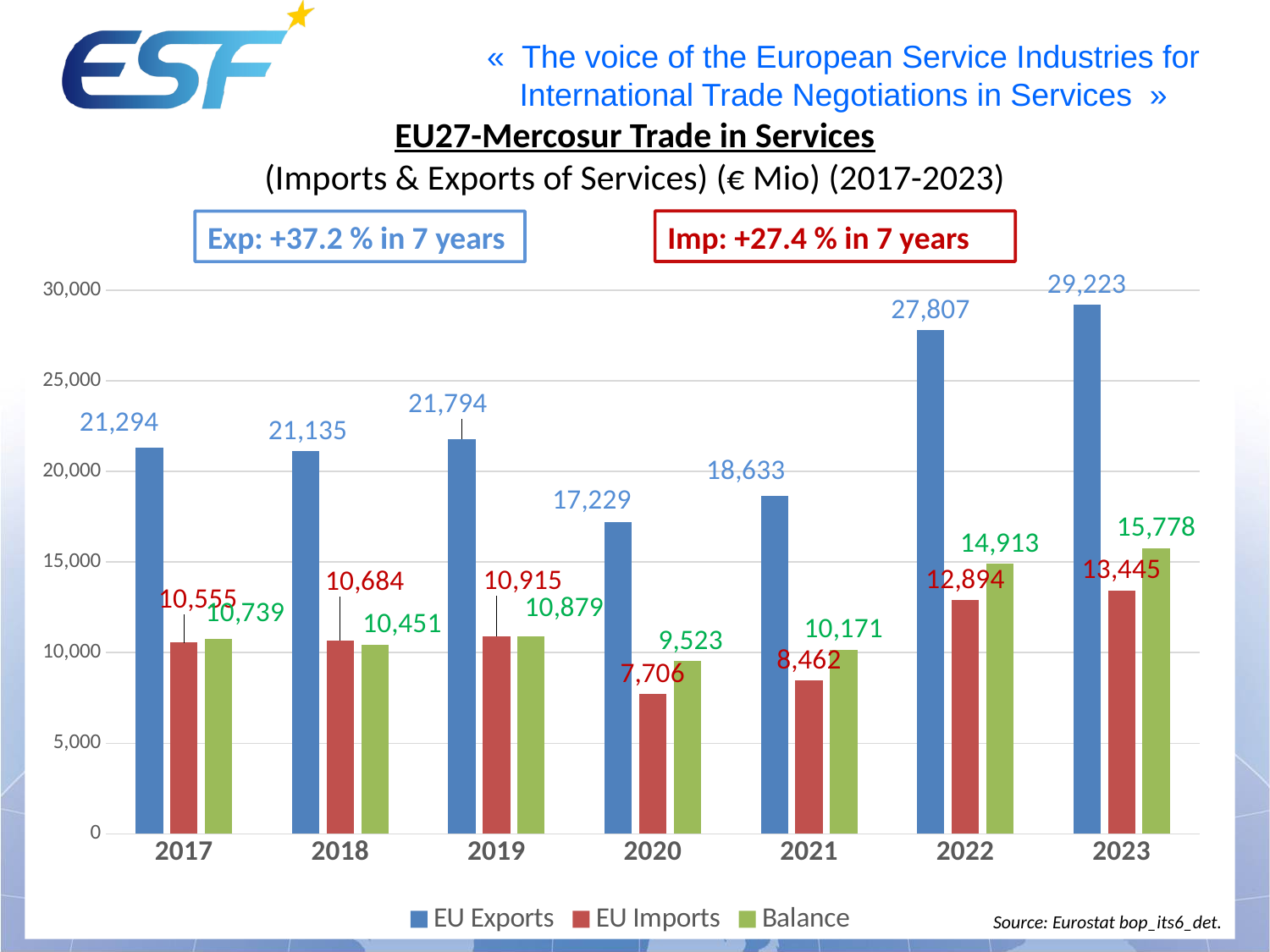
What is the difference between EU Imports in 2021 and EU Imports in 2020? 756 How many years are shown on the x axis? 7 How many series does the legend list? 3 In which year are EU Imports lowest? 2020 What is the value of EU Imports in 2020? 7,706 Is the value for EU Exports in 2021 greater or less than 20,000? less What is the value of EU Exports in 2023? 29,223 What kind of chart is shown on the slide? bar chart What is the Balance value for 2022? 14,913 Which is larger in 2019: EU Imports or Balance? EU Imports In which year are EU Exports highest? 2023 What is the difference between EU Exports in 2023 and EU Exports in 2022? 1,416